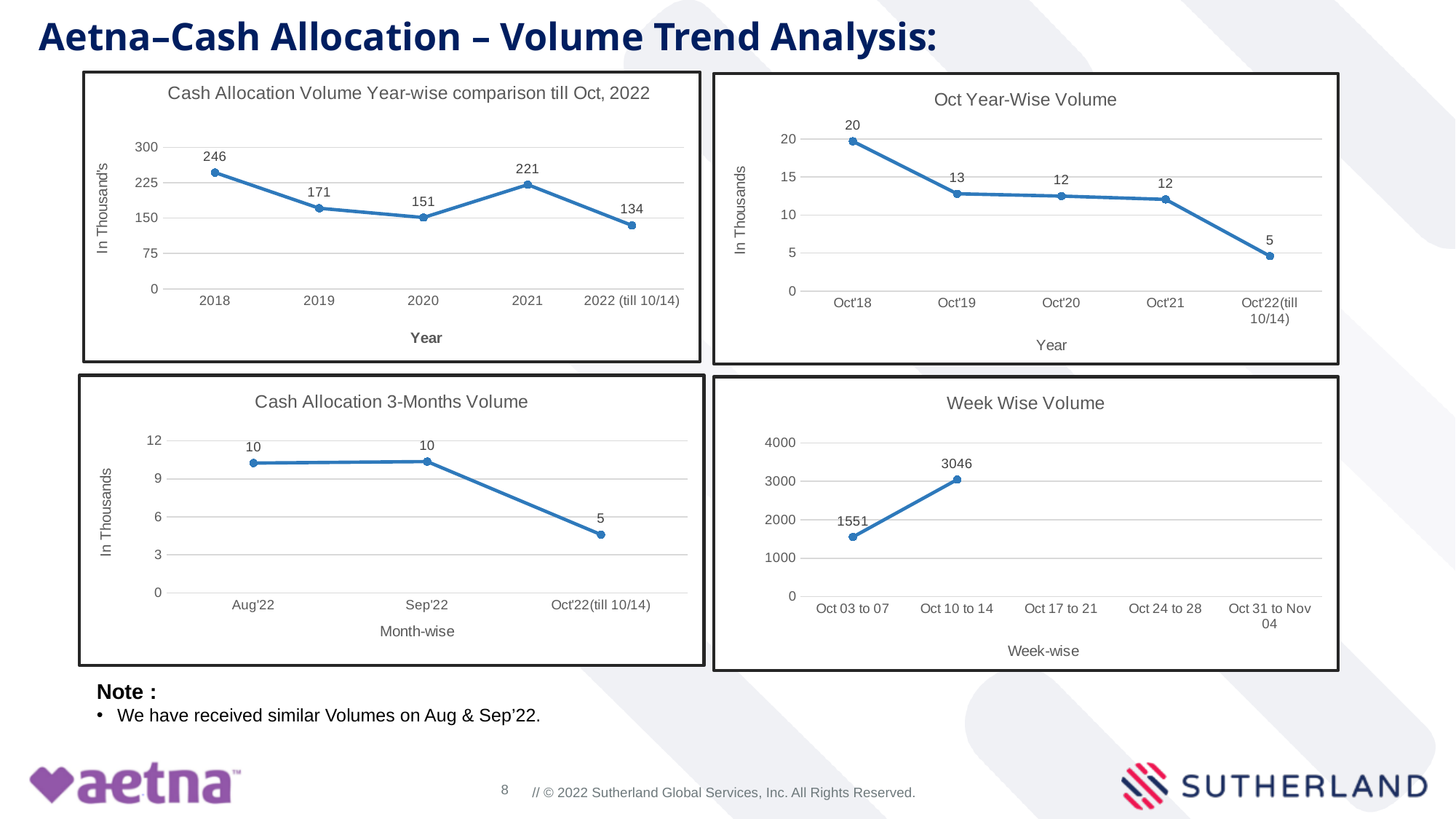
What kind of chart is the 'Week Wise Volume' chart? Line chart In the 'Week Wise Volume' chart, what is the value for Oct 10 to 14? 3046 In the 'Oct Year-Wise Volume' chart, do the values rise or fall from Oct'18 to Oct'22(till 10/14)? Fall In the 'Cash Allocation Volume Year-wise comparison till Oct, 2022' chart, what is the value for 2018? 246 In the 'Week Wise Volume' chart, which is larger, the value for Oct 03 to 07 or Oct 10 to 14? Oct 10 to 14 In the 'Oct Year-Wise Volume' chart, which category has the highest value? Oct'18 In the 'Oct Year-Wise Volume' chart, what is the value for Oct'18? 20 In the 'Oct Year-Wise Volume' chart, how many data points are plotted? 5 In the 'Cash Allocation 3-Months Volume' chart, what is the value for Oct'22(till 10/14)? 5 In the 'Cash Allocation Volume Year-wise comparison till Oct, 2022' chart, which year has the lowest value? 2022 (till 10/14) In the 'Cash Allocation Volume Year-wise comparison till Oct, 2022' chart, what is the difference between the 2021 and 2020 values? 70 In the 'Cash Allocation 3-Months Volume' chart, what is the difference between the Sep'22 and Oct'22(till 10/14) values? 5